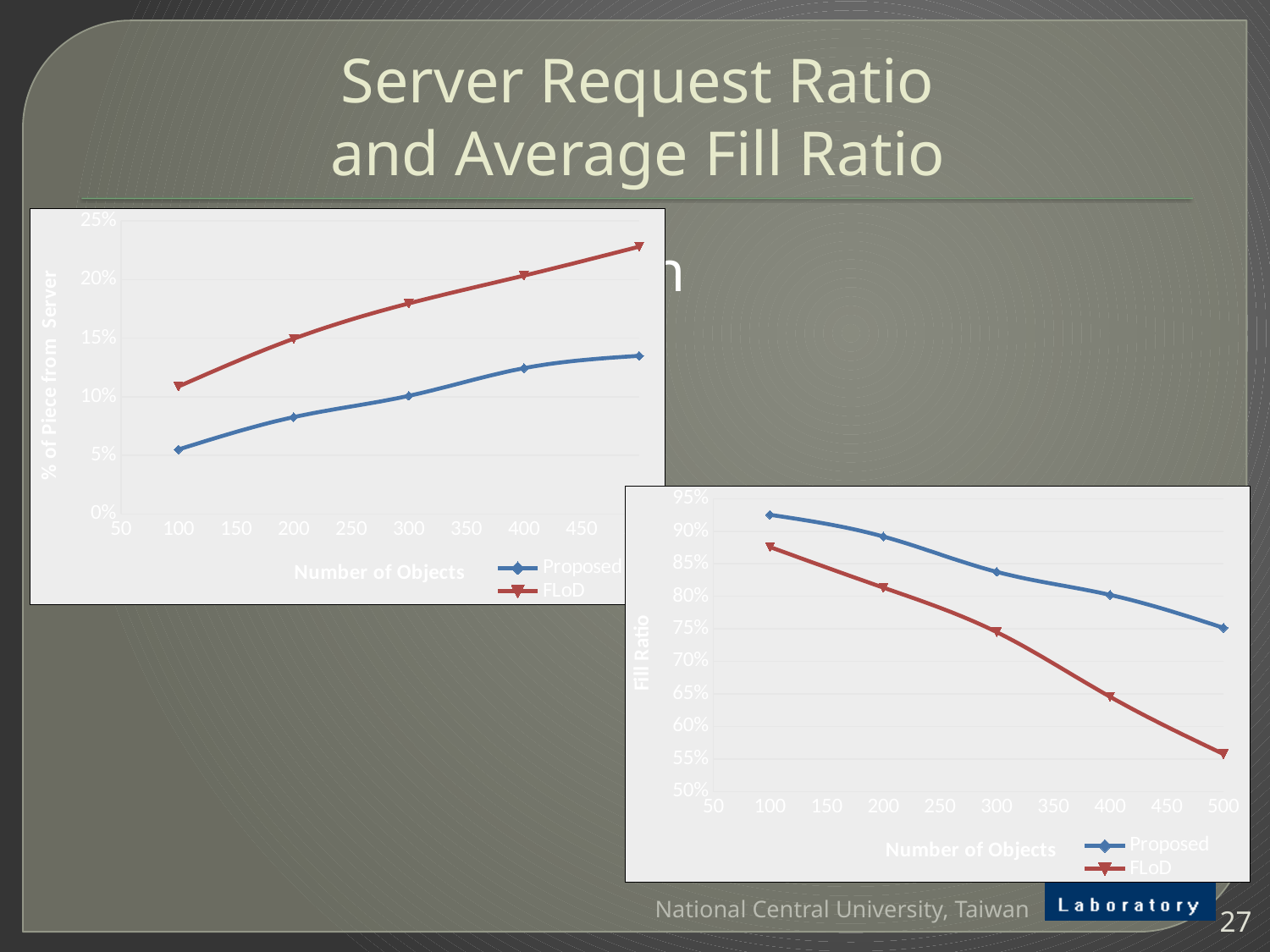
In the upper-left chart (% of Piece from Server), is the value for Proposed at 100 objects greater or less than 10%? less In the upper-left chart (% of Piece from Server), which series has the higher value at 300 objects, Proposed or FLoD? FLoD In the lower-right chart (Fill Ratio), is the value for FLoD at 500 objects greater or less than 60%? less In the upper-left chart (% of Piece from Server), do the values for Proposed rise or fall as the Number of Objects increases? rise In the lower-right chart (Fill Ratio), do the values for FLoD rise or fall as the Number of Objects increases? fall What is the x-axis title of the lower-right chart (Fill Ratio)? Number of Objects In the lower-right chart (Fill Ratio), is the value for Proposed at 100 objects greater or less than 90%? greater What type of chart is the upper-left chart (% of Piece from Server)? line chart How many series does the legend of the lower-right chart (Fill Ratio) list? 2 In the upper-left chart (% of Piece from Server), how many data points does the FLoD series have? 5 In the lower-right chart (Fill Ratio), which series has the higher value at 400 objects, Proposed or FLoD? Proposed